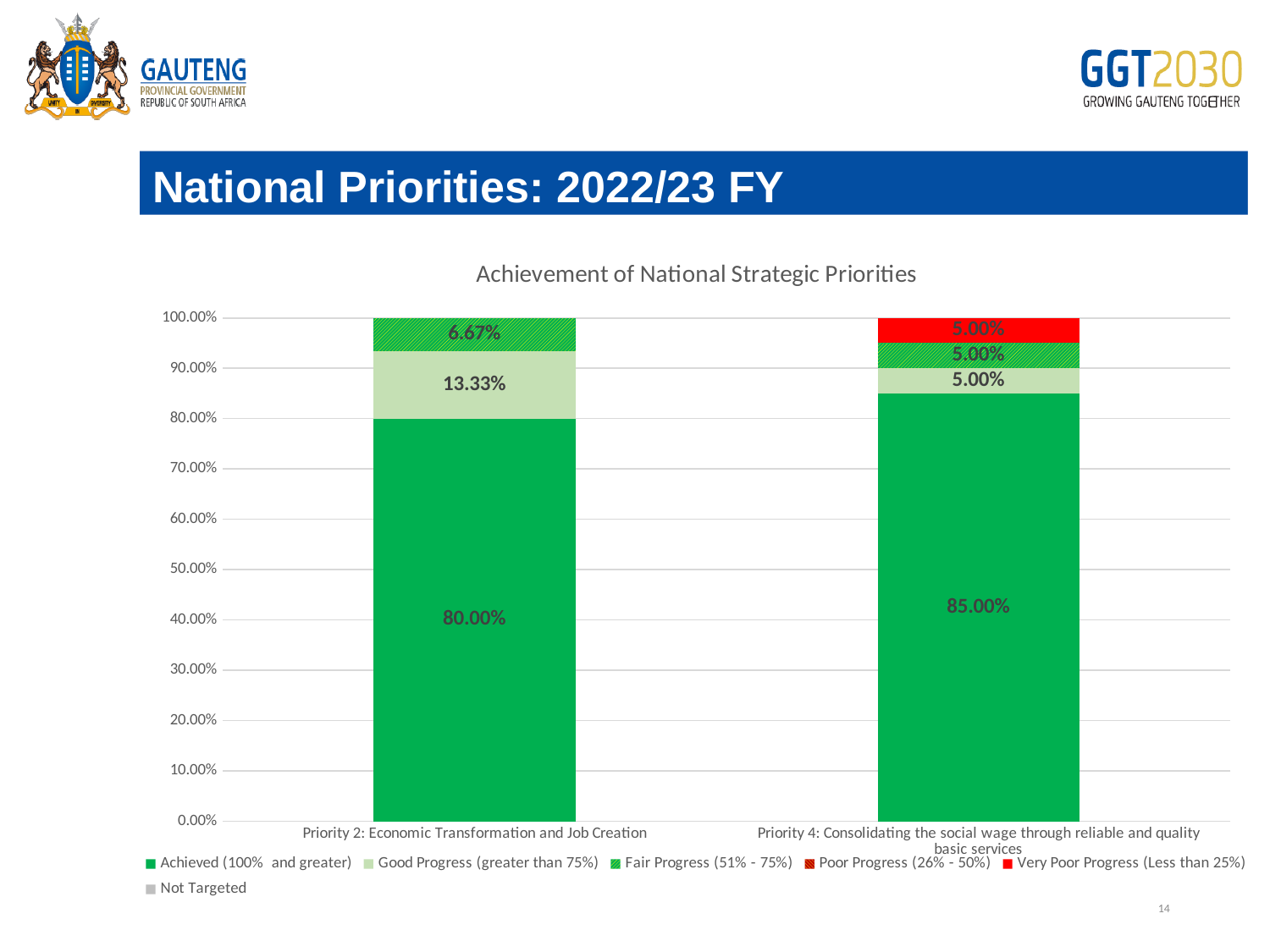
What is the Achieved (100% and greater) value for Priority 4: Consolidating the social wage through reliable and quality basic services? 85.00% What is the title of the chart? Achievement of National Strategic Priorities How many series does the legend list? 6 What is the Good Progress (greater than 75%) value for Priority 4: Consolidating the social wage through reliable and quality basic services? 5.00% What is the difference between the Achieved values for Priority 4 and Priority 2? 5.00% What is the Fair Progress (51% - 75%) value for Priority 2: Economic Transformation and Job Creation? 6.67% What is the Achieved (100% and greater) value for Priority 2: Economic Transformation and Job Creation? 80.00% What type of chart is shown on the slide? Stacked bar chart How many categories (priorities) are plotted on the x axis? 2 Which priority has the higher Achieved (100% and greater) value? Priority 4: Consolidating the social wage through reliable and quality basic services What is the Good Progress (greater than 75%) value for Priority 2: Economic Transformation and Job Creation? 13.33% Is the Achieved (100% and greater) value for Priority 2 greater or less than 70.00%? greater